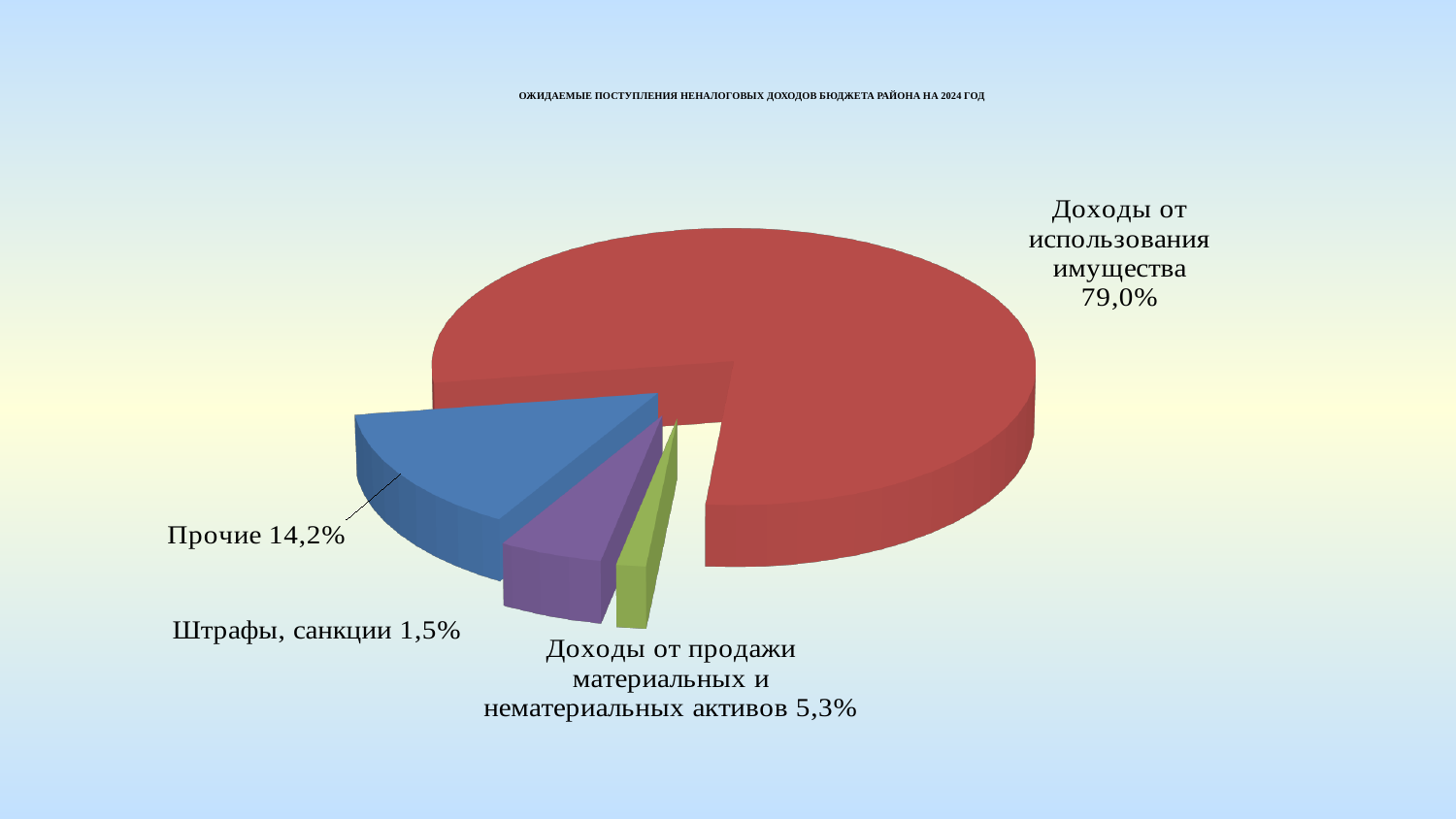
Which category has the largest share of the pie? Доходы от использования имущества What share of the pie does Доходы от продажи материальных и нематериальных активов have? 5,3% What colour is the slice for Доходы от использования имущества? Red What share of the pie does Штрафы, санкции have? 1,5% What share of the pie does Прочие have? 14,2% Which category has the smallest share of the pie? Штрафы, санкции What share of the pie does Доходы от использования имущества have? 79,0% What is the difference in percentage points between Доходы от продажи материальных и нематериальных активов and Штрафы, санкции? 3,8 Which is larger: the share for Прочие or the share for Доходы от продажи материальных и нематериальных активов? Прочие How many slices does the pie chart have? 4 What kind of chart is shown on the slide? Pie chart What is the difference in percentage points between Доходы от использования имущества and Прочие? 64,8